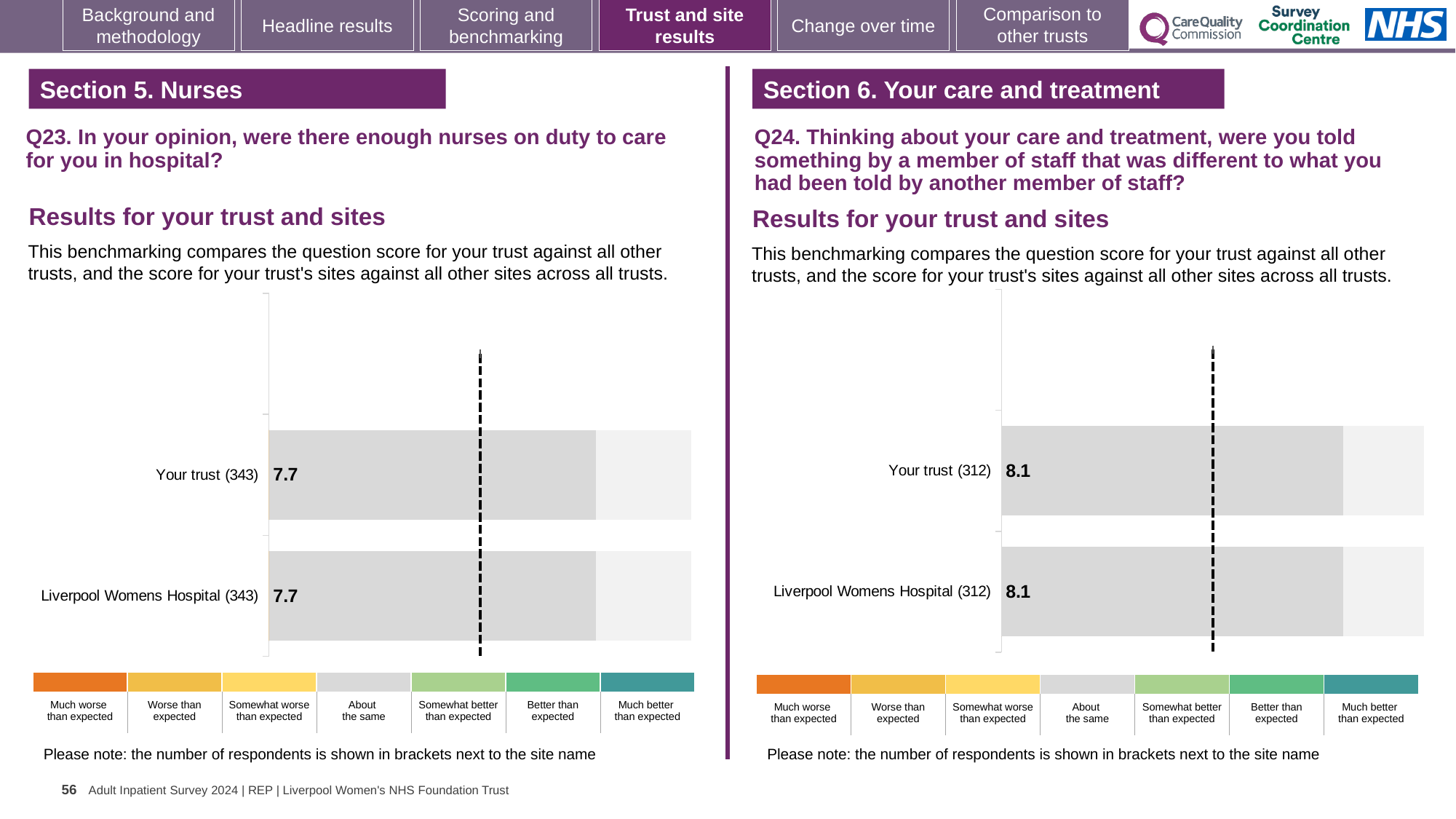
On the Q24 chart (right), what is the difference between the Your trust score and the Liverpool Womens Hospital score? 0 On the Q23 chart (left), what is the score for Liverpool Womens Hospital? 7.7 On the Q24 chart (right), what is the score for Your trust? 8.1 On the Q23 chart (left), what is the score for Your trust? 7.7 On the Q24 chart (right), how many respondents are shown in brackets next to Liverpool Womens Hospital? 312 How many bars are plotted on the Q24 chart (right)? 2 On the Q24 chart (right), what is the score for Liverpool Womens Hospital? 8.1 How many bars are plotted on the Q23 chart (left)? 2 What kind of chart is used on the Q23 chart (left)? Bar chart On the Q23 chart (left), how many respondents are shown in brackets next to Your trust? 343 On the Q23 chart (left), what is the difference between the Your trust score and the Liverpool Womens Hospital score? 0 Is the Your trust score on the Q24 chart (right) larger than the Your trust score on the Q23 chart (left)? Yes